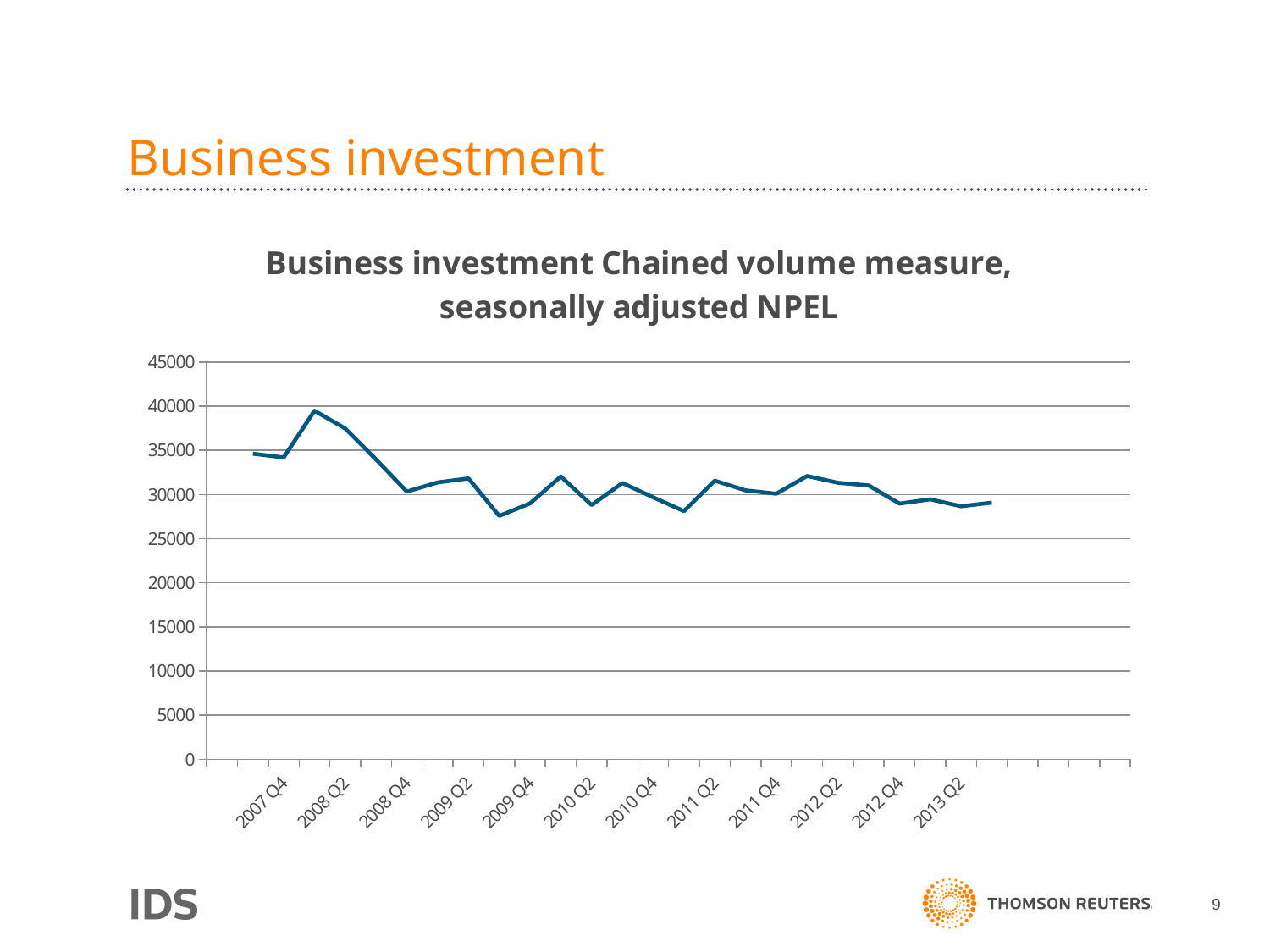
Overall, do the values rise or fall from 2008 Q2 to 2013 Q2? fall What kind of chart is shown on the slide? line chart Is the value for 2012 Q2 greater or less than 30000? greater Is the value for 2009 Q4 greater or less than 30000? less Is the value for 2007 Q4 greater or less than 30000? greater Which labelled quarter on the x axis has the highest value? 2008 Q2 Which is larger, the value for 2009 Q4 or the value for 2007 Q4? 2007 Q4 How many quarter labels are printed on the x axis? 12 What is the title of the chart? Business investment Chained volume measure, seasonally adjusted NPEL Which is larger, the value for 2008 Q2 or the value for 2013 Q2? 2008 Q2